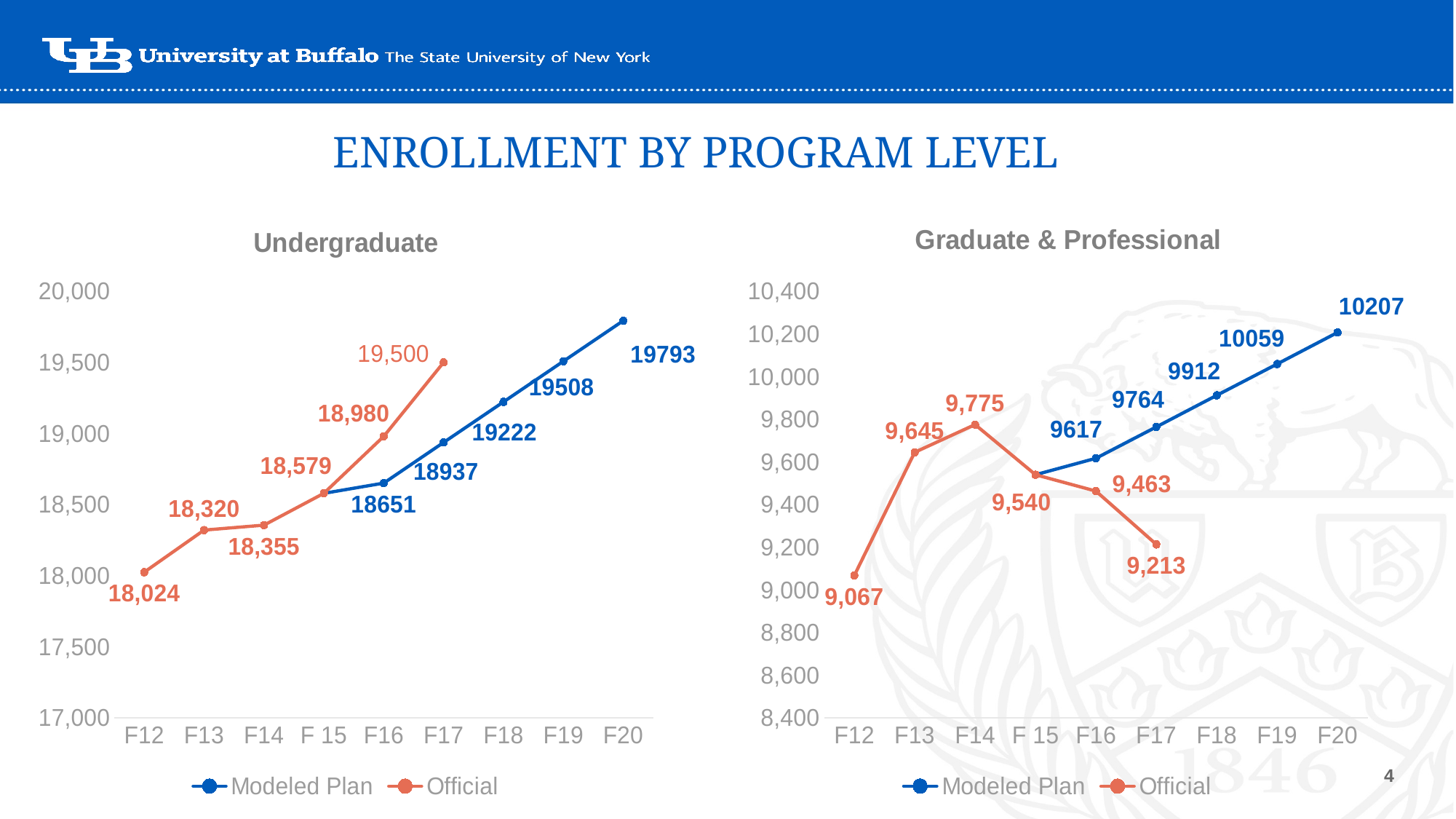
In the Undergraduate chart, which is larger for F17: the Official value or the Modeled Plan value? Official In the Undergraduate chart, what is the difference between the Official values for F17 and F16? 520 In the Graduate & Professional chart, what is the lowest Official value? 9,067 In the Graduate & Professional chart, what is the Modeled Plan value for F20? 10207 In the Graduate & Professional chart, does the Official series rise or fall from F14 to F17? fall What kind of chart is the Undergraduate chart? line chart In the Undergraduate chart, what is the Official value for F17? 19,500 In the Graduate & Professional chart, what is the difference between the Modeled Plan values for F20 and F19? 148 In the Undergraduate chart, what is the Official enrollment value for F12? 18,024 How many series does the legend of the Undergraduate chart list? 2 In the Undergraduate chart, what is the Modeled Plan value for F20? 19793 In the Graduate & Professional chart, in which year does the Official series reach its highest value? F14